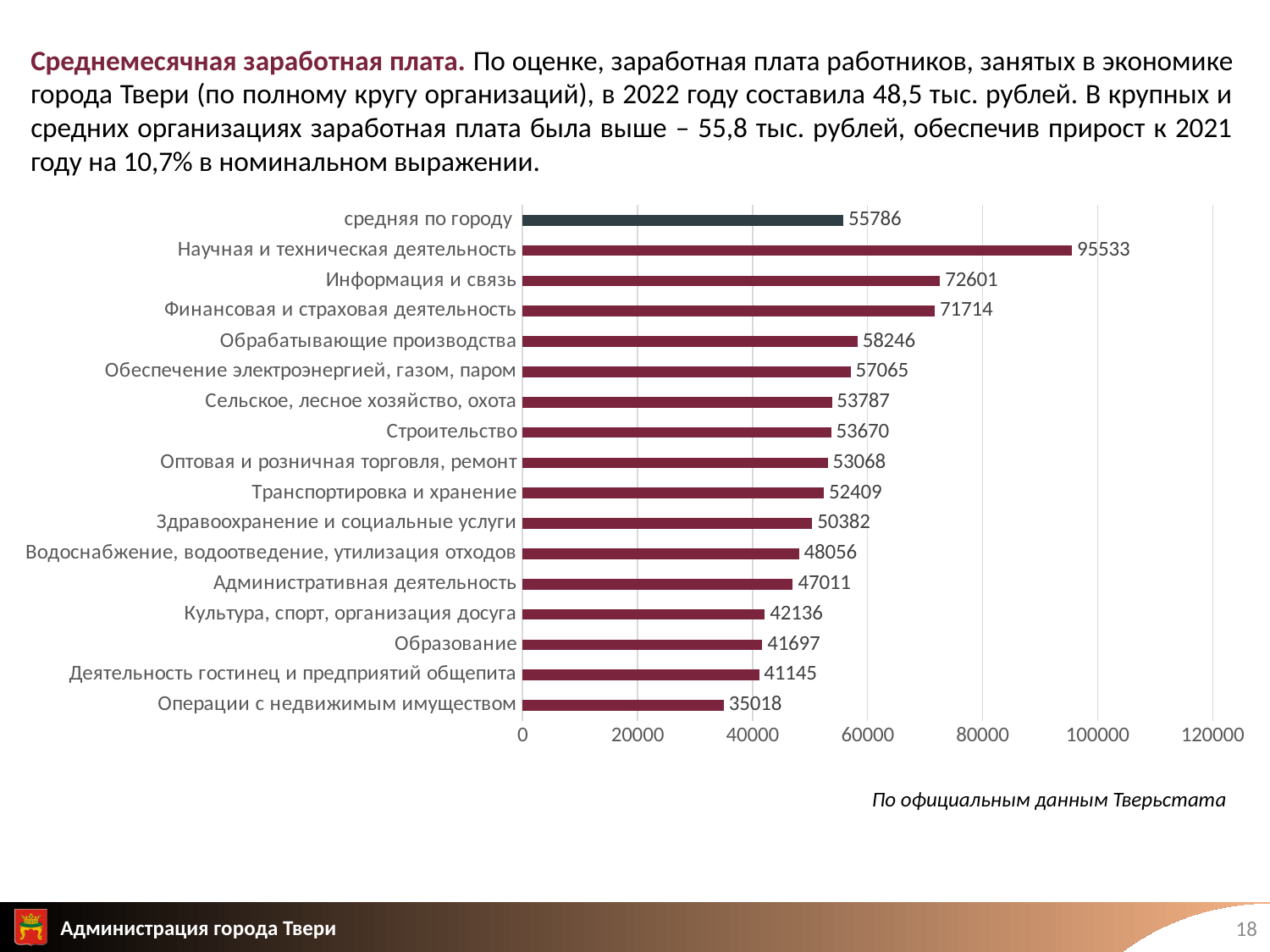
Which bar is drawn in a different colour from the rest? средняя по городу How many categories (bars) are shown in the chart? 17 Is the value for Культура, спорт, организация досуга greater or less than 60000? less Which is larger, the value for Обрабатывающие производства or the value for Обеспечение электроэнергией, газом, паром? Обрабатывающие производства Which category has the lowest value? Операции с недвижимым имуществом What is the value shown for Образование? 41697 What kind of chart is shown on the slide? bar chart What is the difference between the values for Научная и техническая деятельность and Операции с недвижимым имуществом? 60515 Which category has the highest value? Научная и техническая деятельность What is the value shown for Научная и техническая деятельность? 95533 What is the value shown for средняя по городу? 55786 What is the difference between the values for Информация и связь and Финансовая и страховая деятельность? 887